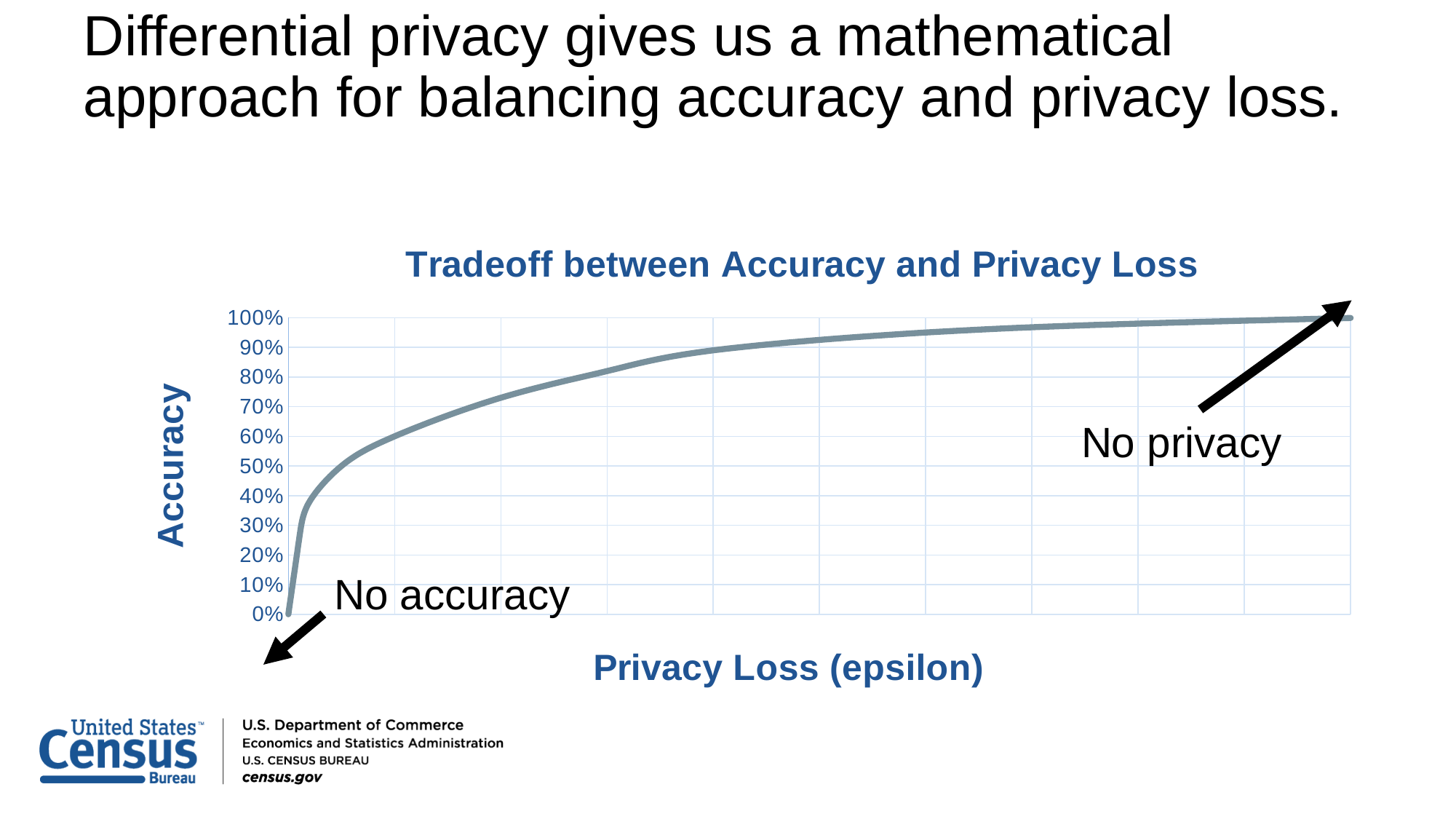
What is the label of the vertical axis of the chart? Accuracy At which end of the curve, left or right, is accuracy highest? right Is the accuracy at the far left end of the curve greater or less than 10%? less What is the highest value shown on the Accuracy axis? 100% Does accuracy rise or fall as privacy loss (epsilon) increases along the x axis? rise What is the lowest value shown on the Accuracy axis? 0% What kind of chart is shown on the slide? line chart What is the title of the chart? Tradeoff between Accuracy and Privacy Loss At which end of the curve, left or right, is accuracy lowest? left Is the accuracy at the far right end of the curve greater or less than 90%? greater